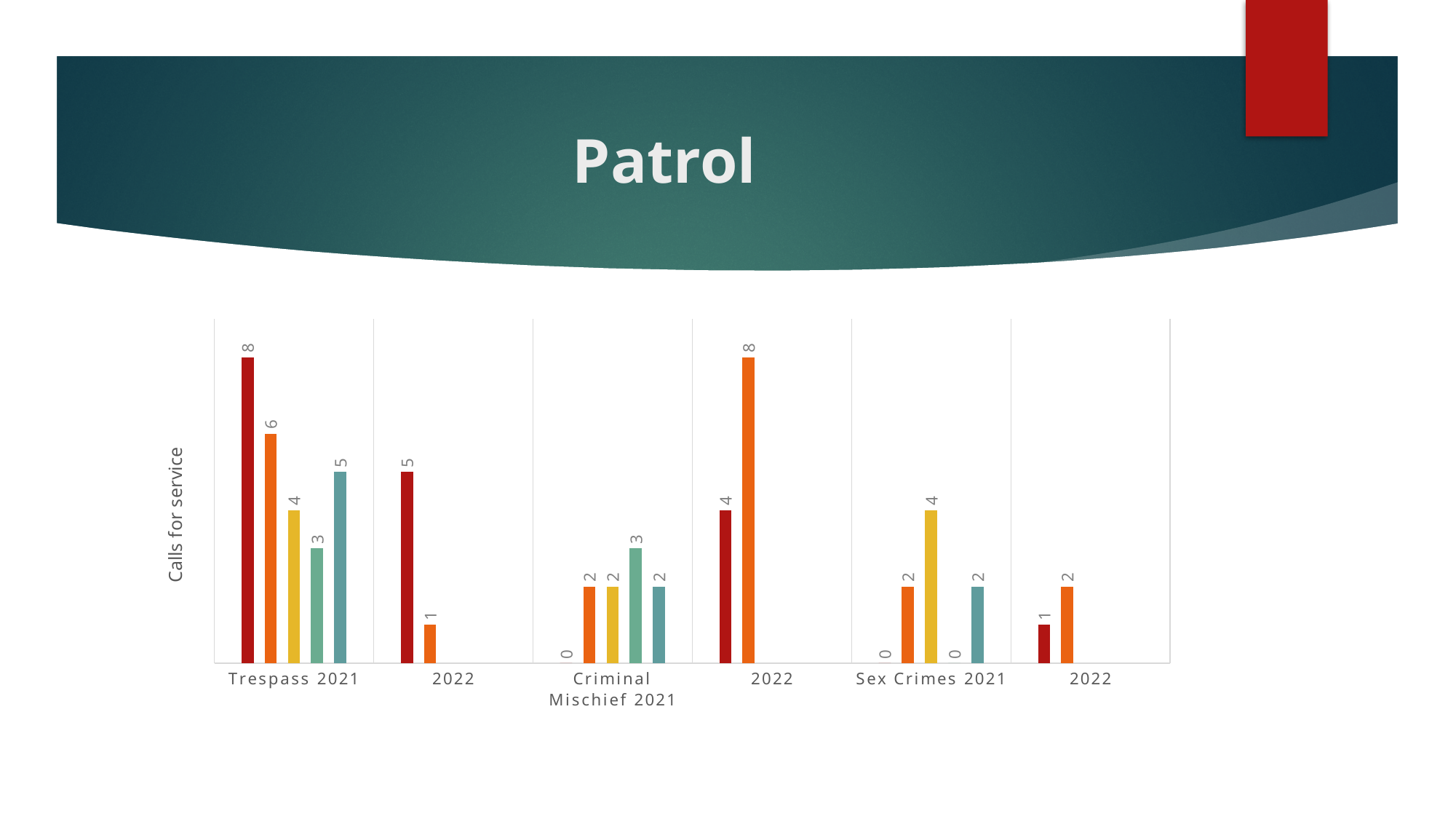
What is the difference between the dark red bar and the orange bar for Trespass 2021? 2 What is the value of the dark red bar for Trespass 2021? 8 Which is larger: the orange bar for Trespass 2021 or the orange bar in the 2022 category following Criminal Mischief 2021? the 2022 category following Criminal Mischief 2021 How many categories are shown along the x axis of the chart? 6 What is the title of the vertical axis of the chart? Calls for service What is the value of the yellow bar for Sex Crimes 2021? 4 What is the difference between the dark red bar and the orange bar in the 2022 category following Trespass 2021? 4 What is the value of the orange bar in the 2022 category following Criminal Mischief 2021? 8 What is the value of the green bar for Criminal Mischief 2021? 3 Which bar is the highest within the Trespass 2021 category? the dark red bar (8) What kind of chart is shown on the slide? bar chart What is the value of the teal bar for Trespass 2021? 5